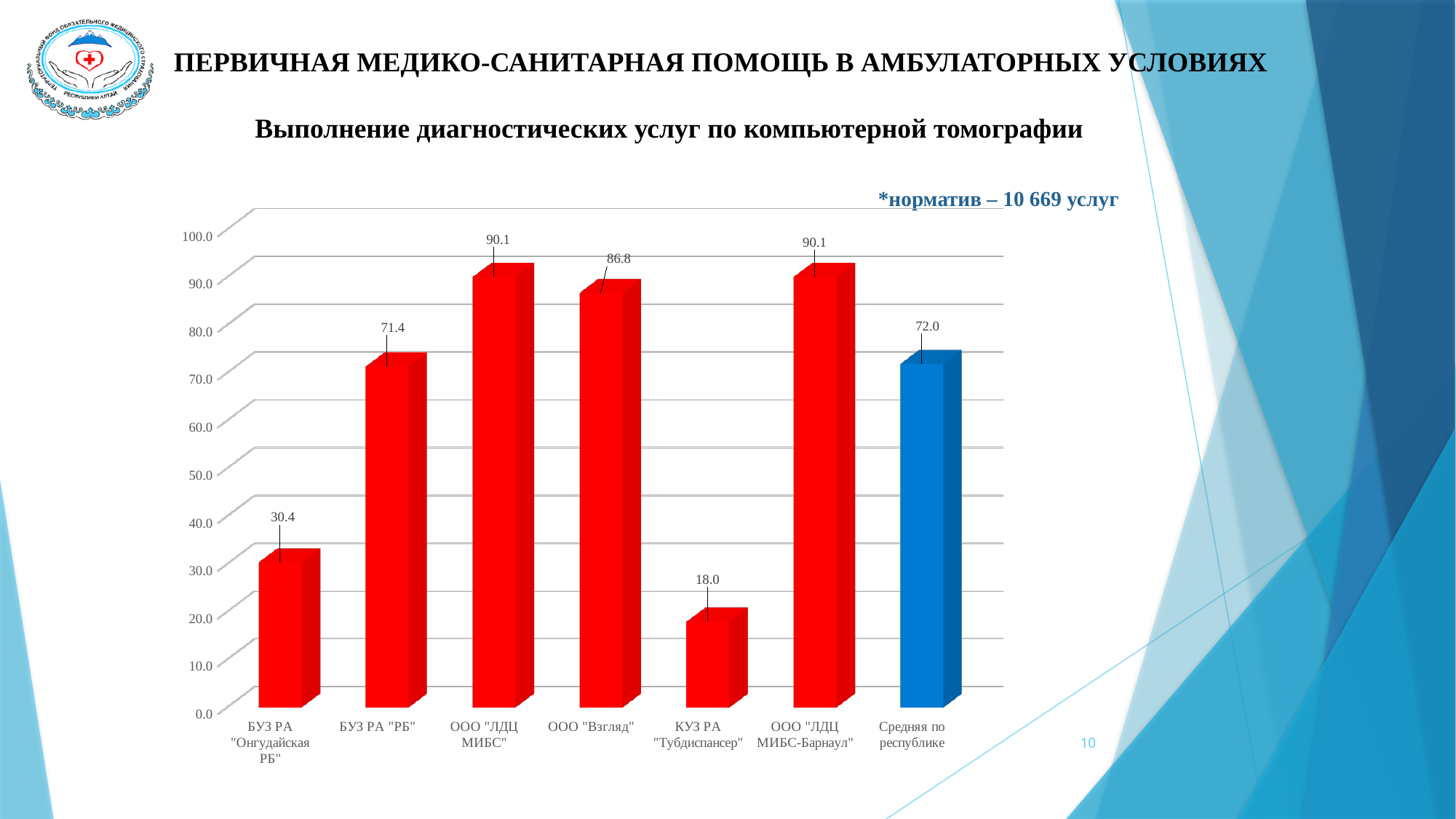
What is the difference between the values for Средняя по республике and БУЗ РА "РБ"? 0.6 How many categories are shown on the x axis? 7 What kind of chart is shown on the slide? bar chart What is the difference between the values for ООО "ЛДЦ МИБС" and ООО "Взгляд"? 3.3 What is the value for КУЗ РА "Тубдиспансер"? 18.0 What is the chart's title? Выполнение диагностических услуг по компьютерной томографии Which category has the lowest value? КУЗ РА "Тубдиспансер" What is the value for БУЗ РА "Онгудайская РБ"? 30.4 What is the value for Средняя по республике? 72.0 Is the value for ООО "ЛДЦ МИБС-Барнаул" greater or less than 80.0? greater Which is larger, the value for БУЗ РА "РБ" or the value for БУЗ РА "Онгудайская РБ"? БУЗ РА "РБ" What is the value for ООО "Взгляд"? 86.8